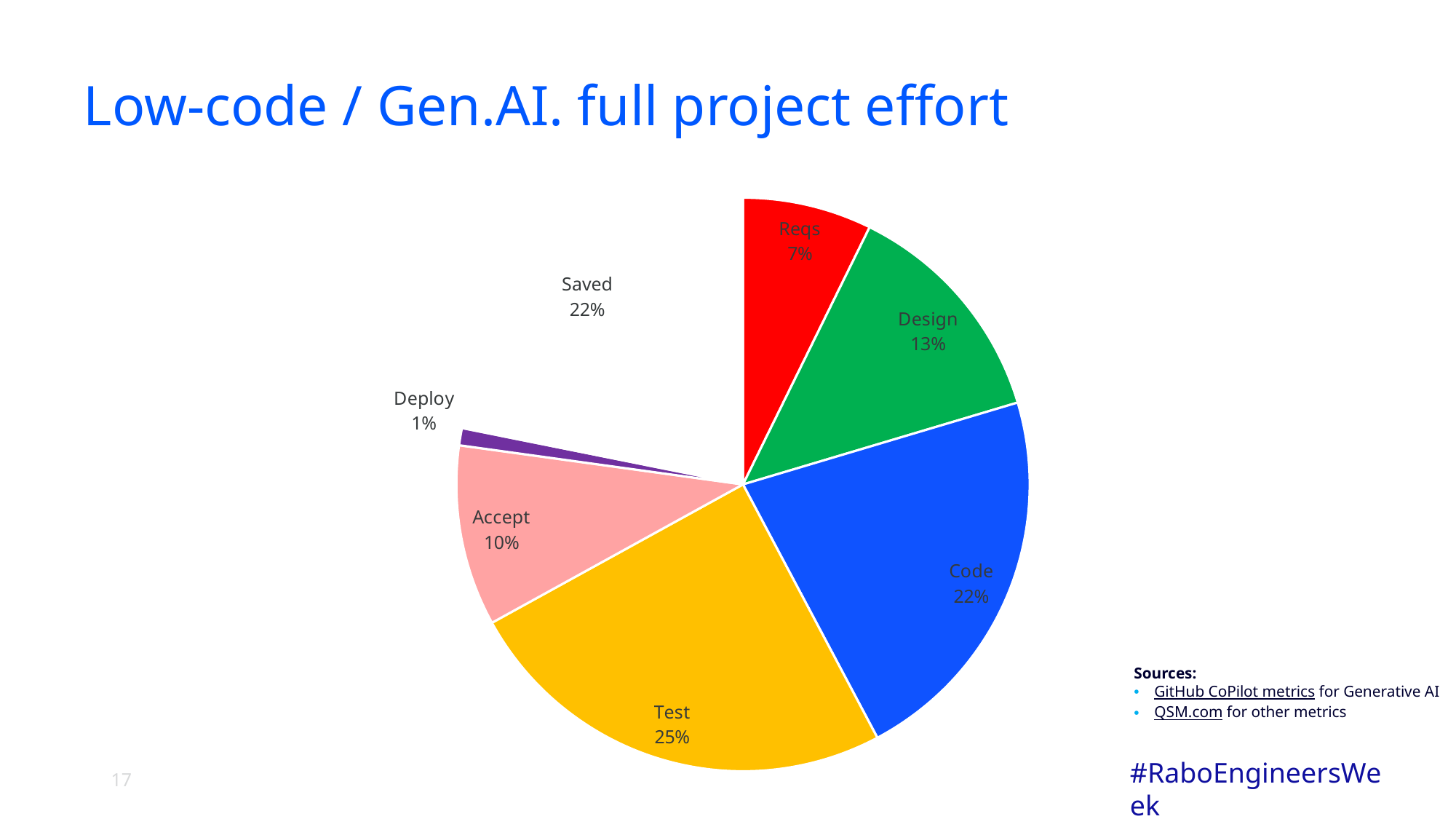
What is the value shown for Accept? 10% What kind of chart is shown on the slide? pie chart What is the difference between the Code and Reqs percentages? 15% What is the value shown for Design? 13% How many categories are shown in the pie chart? 7 What is the value shown for Deploy? 1% Which is larger, the Design slice or the Accept slice? Design What share of the pie does the Test slice represent? 25% What is the title of the slide containing the chart? Low-code / Gen.AI. full project effort Which category has the smallest slice of the pie? Deploy What colour is the Code slice? blue Which category has the largest slice of the pie? Test